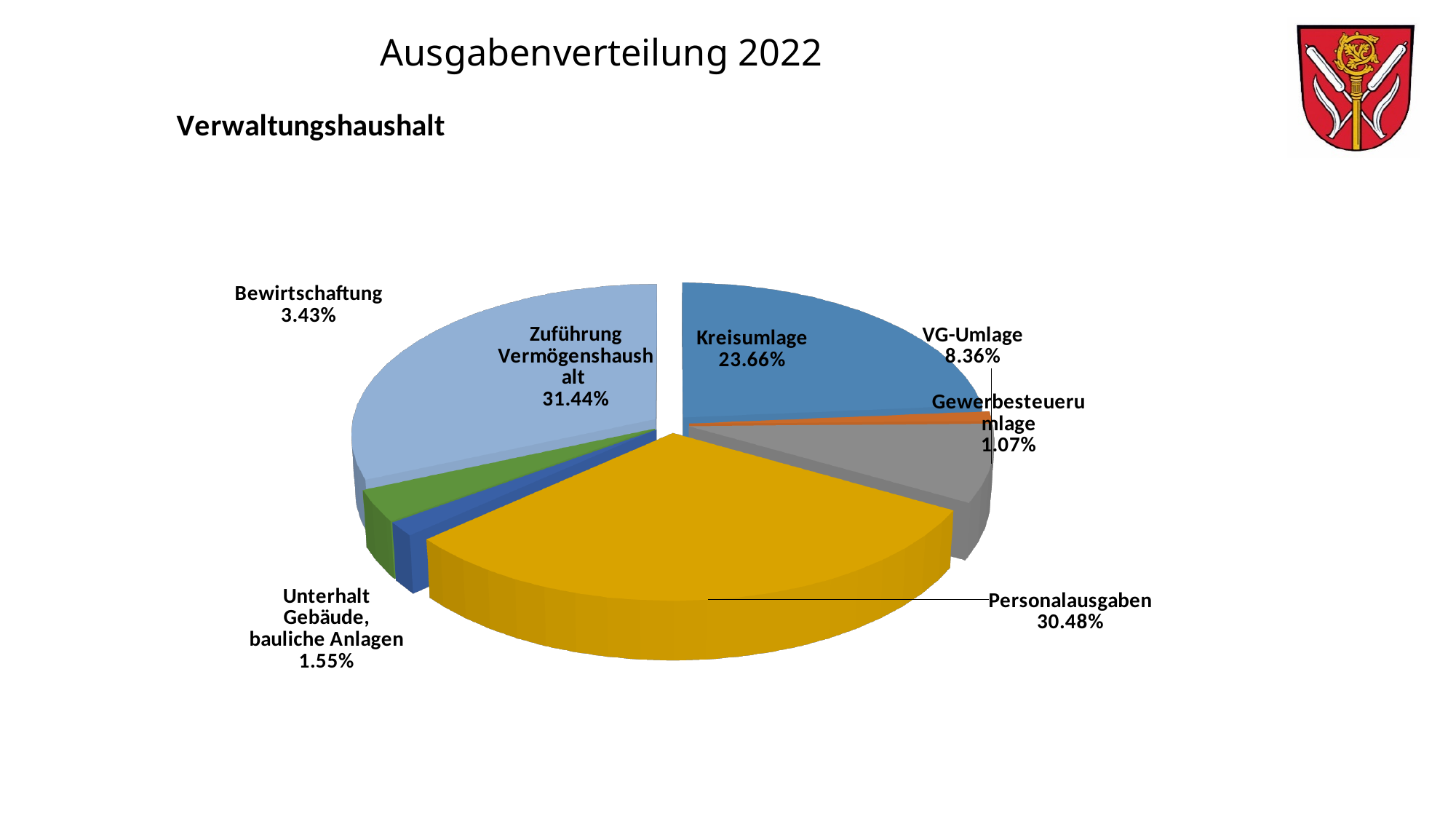
Which category has the largest share of the pie? Zuführung Vermögenshaushalt What is the value shown for Gewerbesteuerumlage? 1.07% What is the value shown for Kreisumlage? 23.66% What is the title of the slide containing the chart? Ausgabenverteilung 2022 Which category has the smallest share of the pie? Gewerbesteuerumlage What is the value shown for Bewirtschaftung? 3.43% What is the difference between the shares of Zuführung Vermögenshaushalt and Personalausgaben? 0.96% What is the value shown for VG-Umlage? 8.36% Which is larger, the share for Kreisumlage or the share for VG-Umlage? Kreisumlage What share of the pie does Personalausgaben have? 30.48% What kind of chart is shown on the slide? Pie chart How many slices does the pie chart have? 7